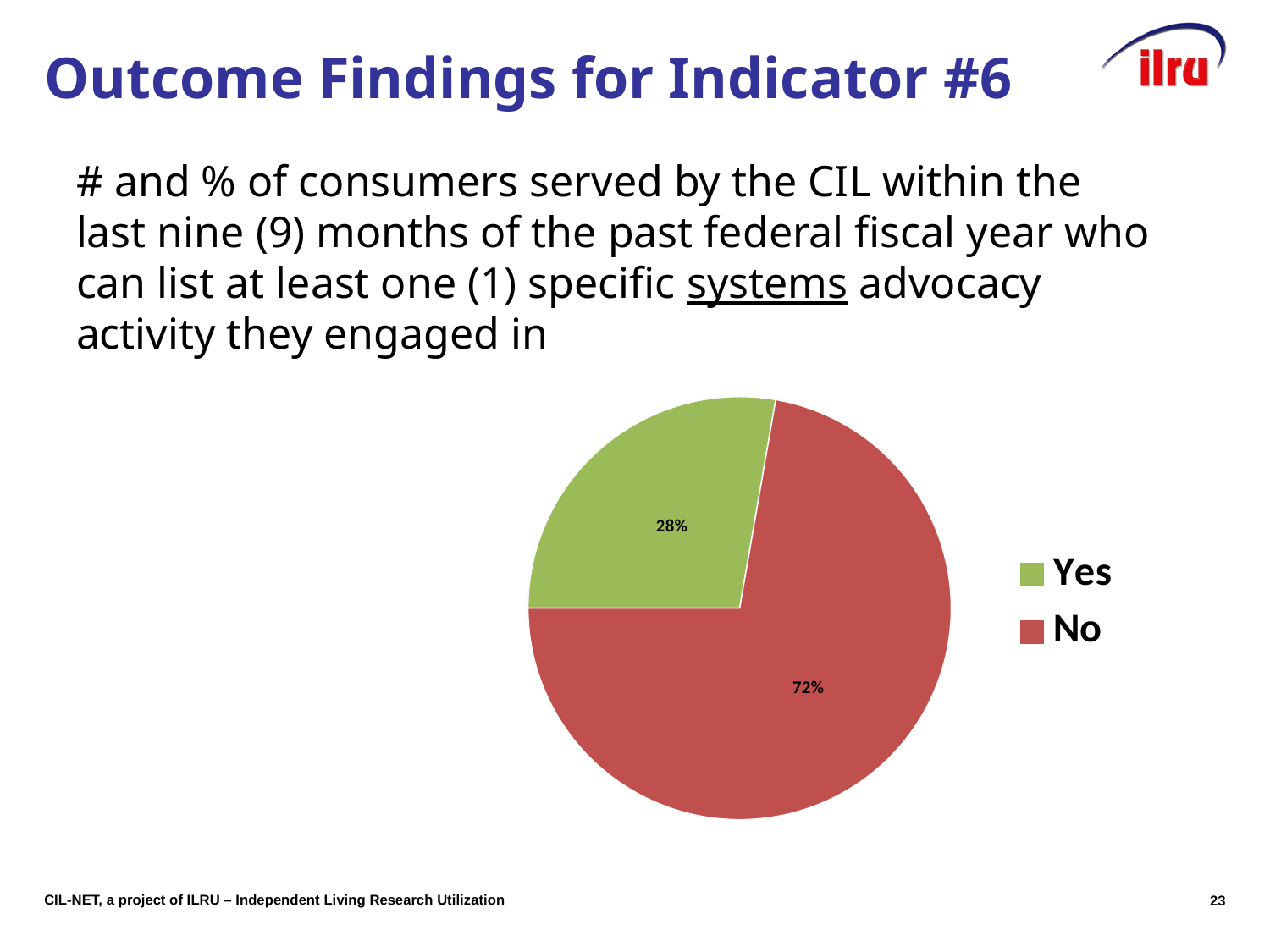
What share of the pie does the "No" slice represent? 72% Which slice of the pie is the largest? No How many slices does the pie chart have? 2 What percentage of the pie is labelled "Yes"? 28% What colour is the "No" slice in the pie chart? red What colour is the "Yes" slice in the pie chart? green Which slice of the pie is the smallest? Yes What kind of chart is shown on the slide? pie chart What percentage of the pie is labelled "No"? 72% How many entries does the legend list? 2 Which is larger, the "Yes" slice or the "No" slice? No What is the difference in percentage points between the "No" slice and the "Yes" slice? 44